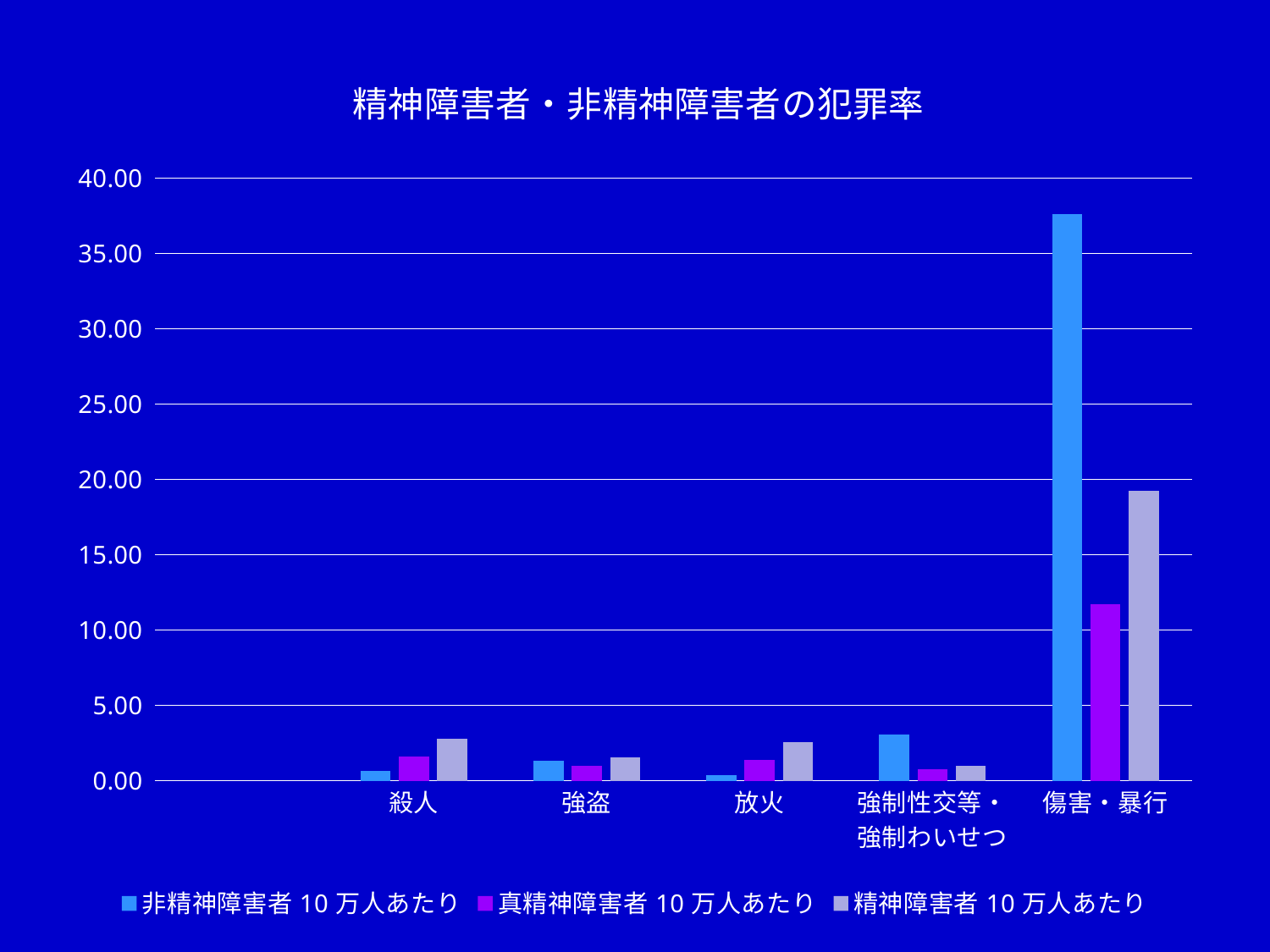
Which category has the highest value for 非精神障害者 10 万人あたり? 傷害・暴行 How many categories are shown on the x axis? 5 Which category has the highest value for 精神障害者 10 万人あたり? 傷害・暴行 In 傷害・暴行, which series has the larger value: 非精神障害者 10 万人あたり or 精神障害者 10 万人あたり? 非精神障害者 10 万人あたり How many series does the legend list? 3 In 殺人, which series has the larger value: 非精神障害者 10 万人あたり or 精神障害者 10 万人あたり? 精神障害者 10 万人あたり Which series is shown in purple in the legend? 真精神障害者 10 万人あたり What kind of chart is shown on the slide? bar chart Is the value for 非精神障害者 10 万人あたり in 傷害・暴行 greater or less than 35.00? greater What is the title of the chart? 精神障害者・非精神障害者の犯罪率 Is the value for 真精神障害者 10 万人あたり in 傷害・暴行 greater or less than 15.00? less Is the value for 精神障害者 10 万人あたり in 傷害・暴行 greater or less than 15.00? greater